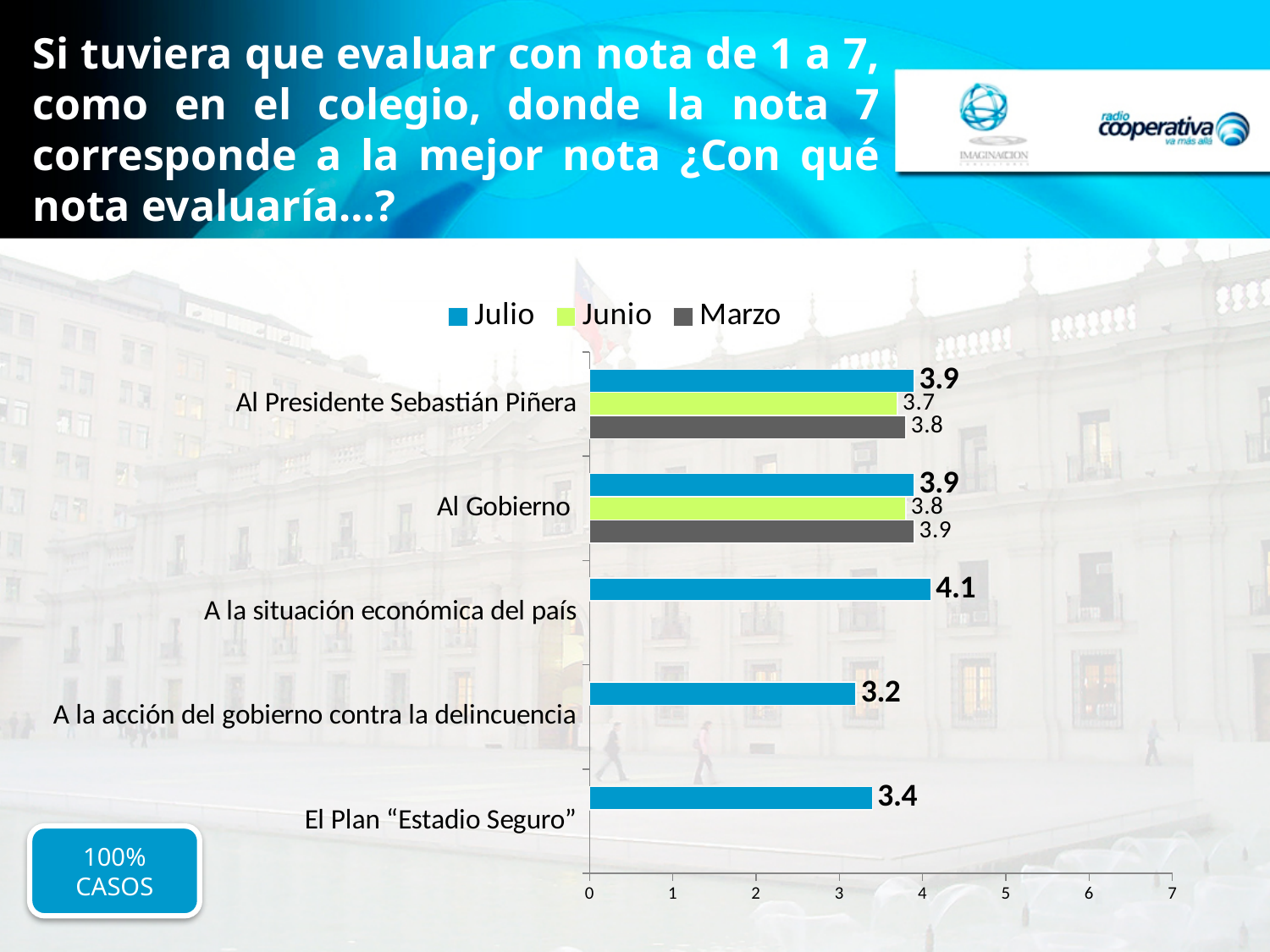
What is the difference between the Julio values for "A la situación económica del país" and "A la acción del gobierno contra la delincuencia"? 0.9 Which category has the lowest Julio value? A la acción del gobierno contra la delincuencia How many categories are shown on the chart? 5 What kind of chart is shown on the slide? bar chart Which category has the highest Julio value? A la situación económica del país Which is larger for "Al Presidente Sebastián Piñera": the Julio value or the Junio value? Julio What is the Julio value for "A la situación económica del país"? 4.1 What is the Junio value for "Al Presidente Sebastián Piñera"? 3.7 How many series does the legend list? 3 What is the Marzo value for "Al Gobierno"? 3.9 What is the Julio value for "Al Presidente Sebastián Piñera"? 3.9 Which series is shown in green in the legend? Junio